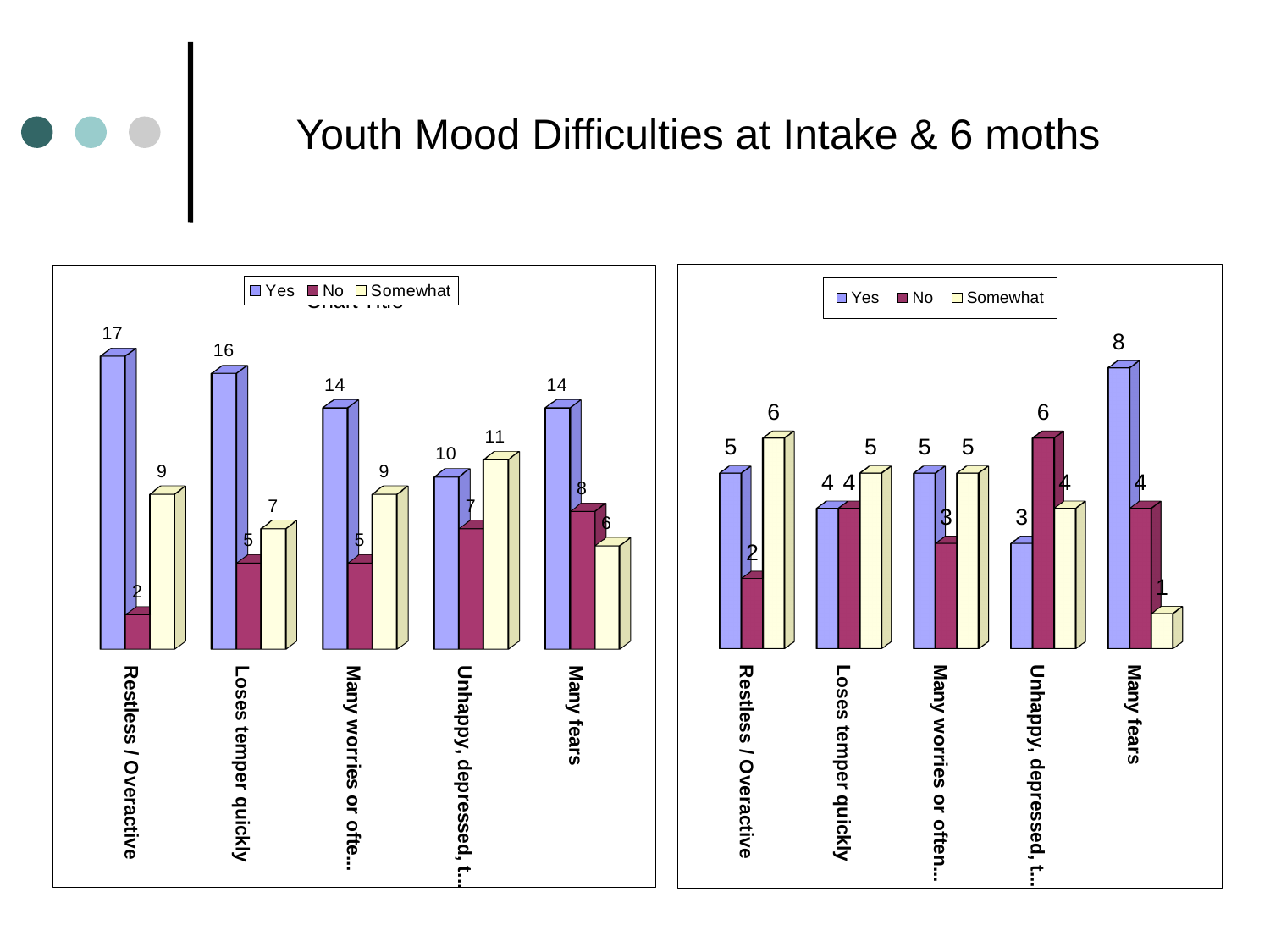
In the right chart, which is larger for Restless / Overactive: the Yes value or the Somewhat value? Somewhat In the right chart, what is the Somewhat value for Many fears? 1 How many categories are shown on the x axis of the right chart? 5 In the right chart, what is the total of the Yes, No and Somewhat values for Loses temper quickly? 13 How many series does the legend of the left chart list? 3 In the right chart, which category has the lowest Somewhat value? Many fears In the left chart, which category has the highest Yes value? Restless / Overactive What kind of chart is the chart on the right? Bar chart In the left chart, what is the difference between the Yes and No values for Loses temper quickly? 11 In the right chart, what is the No value for Unhappy, depressed? 6 In the left chart, what is the No value for Many fears? 8 In the left chart, what is the Yes value for Restless / Overactive? 17